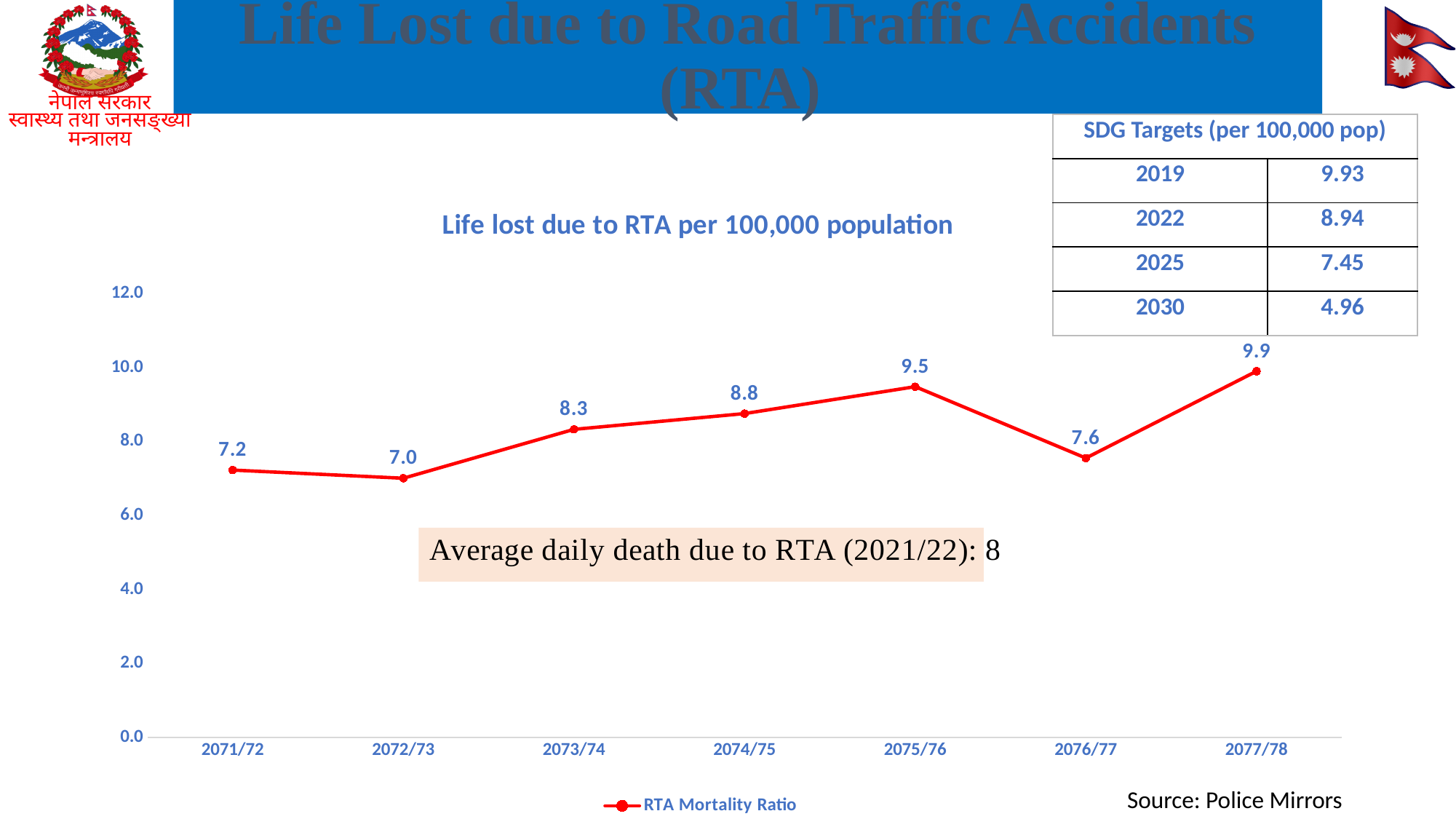
Which year has the lowest RTA mortality ratio? 2072/73 Which is larger, the RTA mortality ratio in 2074/75 or in 2076/77? 2074/75 What is the RTA mortality ratio for 2071/72? 7.2 What is the difference between the RTA mortality ratio in 2077/78 and in 2076/77? 2.3 What is the RTA mortality ratio for 2077/78? 9.9 What is the RTA mortality ratio for 2075/76? 9.5 How many years are plotted on the chart? 7 Which year has the highest RTA mortality ratio? 2077/78 Is the RTA mortality ratio for 2073/74 greater or less than 8.0? greater How many series does the legend list? 1 What is the title of the chart? Life lost due to RTA per 100,000 population What kind of chart is shown? line chart